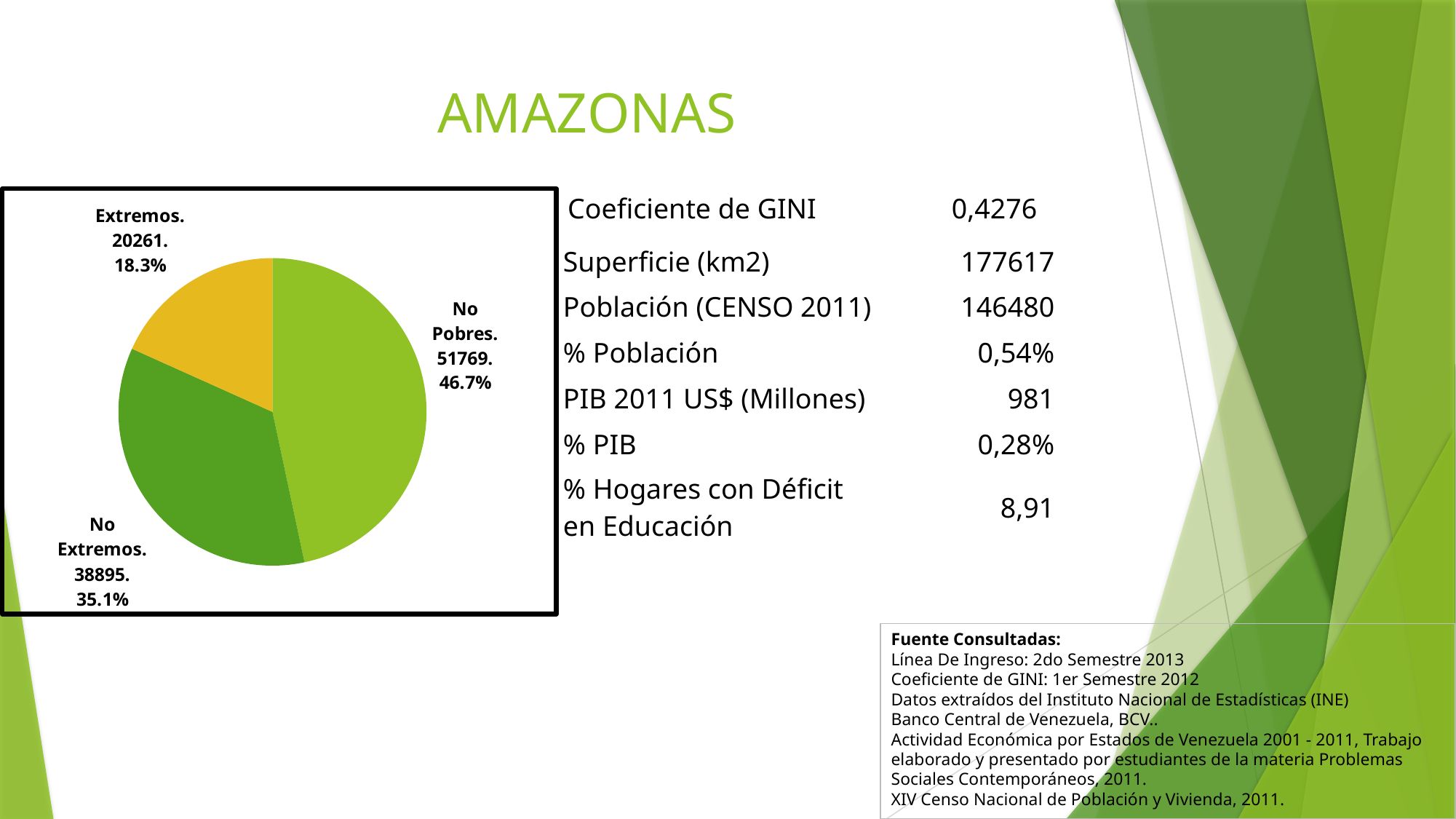
What colour is the Extremos slice? yellow What is the value for the No Pobres slice? 51769 Which slice is the smallest? Extremos Which slice is the largest? No Pobres What is the difference between the No Pobres value and the No Extremos value? 12874 What kind of chart is shown on the slide? pie chart How many slices does the pie chart have? 3 What is the value for the Extremos slice? 20261 What share of the pie does the Extremos slice represent? 18.3% What is the value for the No Extremos slice? 38895 What share of the pie does the No Pobres slice represent? 46.7% Which is larger, the No Extremos slice or the Extremos slice? No Extremos